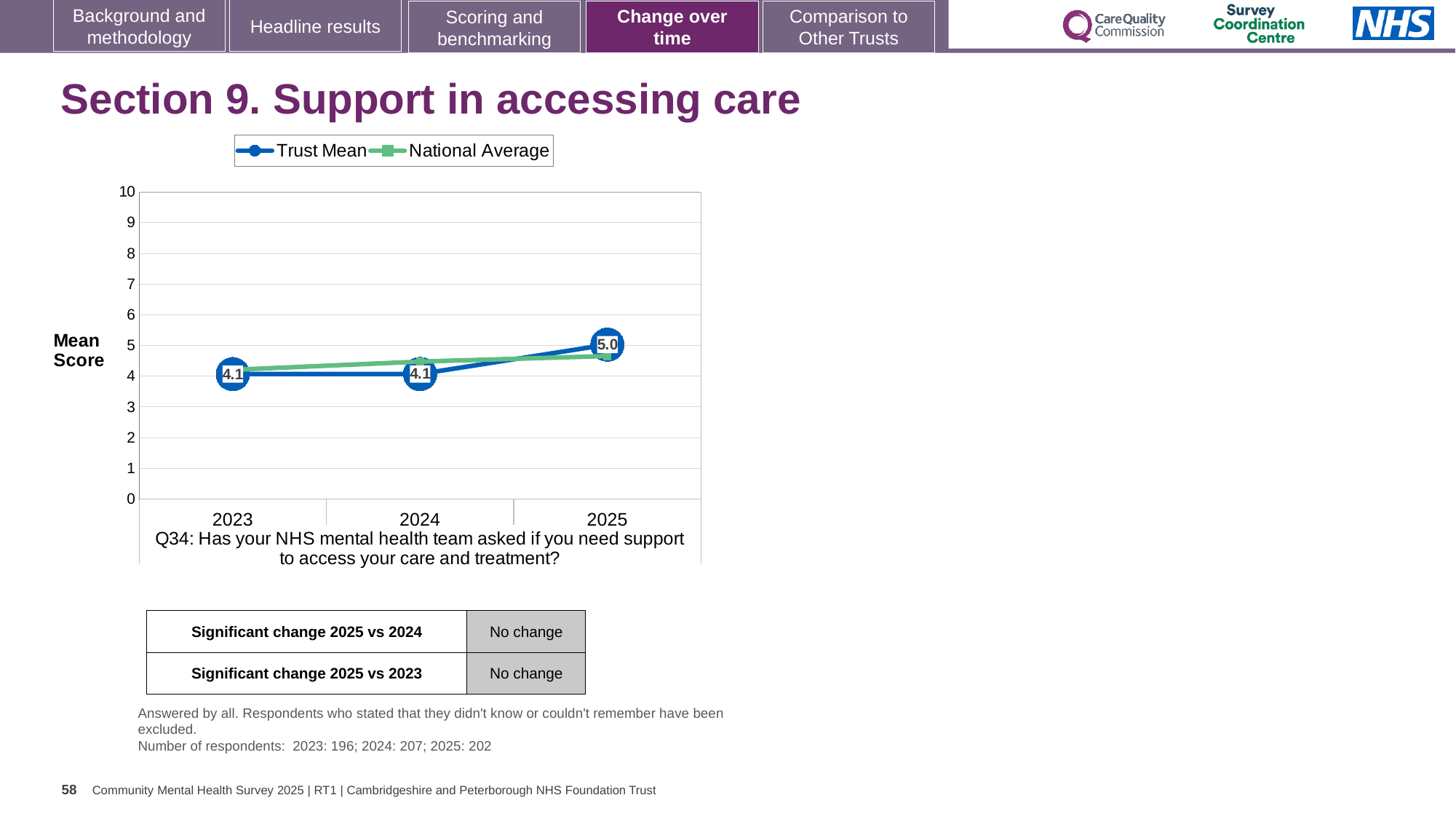
How many series does the chart legend list? 2 What is the Trust Mean score for 2023? 4.1 In 2025, which is higher: the Trust Mean or the National Average? Trust Mean What is the Trust Mean score for 2025? 5.0 Does the Trust Mean rise or fall from 2024 to 2025? rise In 2024, which is higher: the Trust Mean or the National Average? National Average What kind of chart is shown on the slide? line chart What is the difference between the Trust Mean score in 2025 and in 2023? 0.9 What is the Trust Mean score for 2024? 4.1 How many years are plotted on the x axis of the chart? 3 In which year is the Trust Mean score highest? 2025 Is the National Average value for 2025 greater or less than 5? less